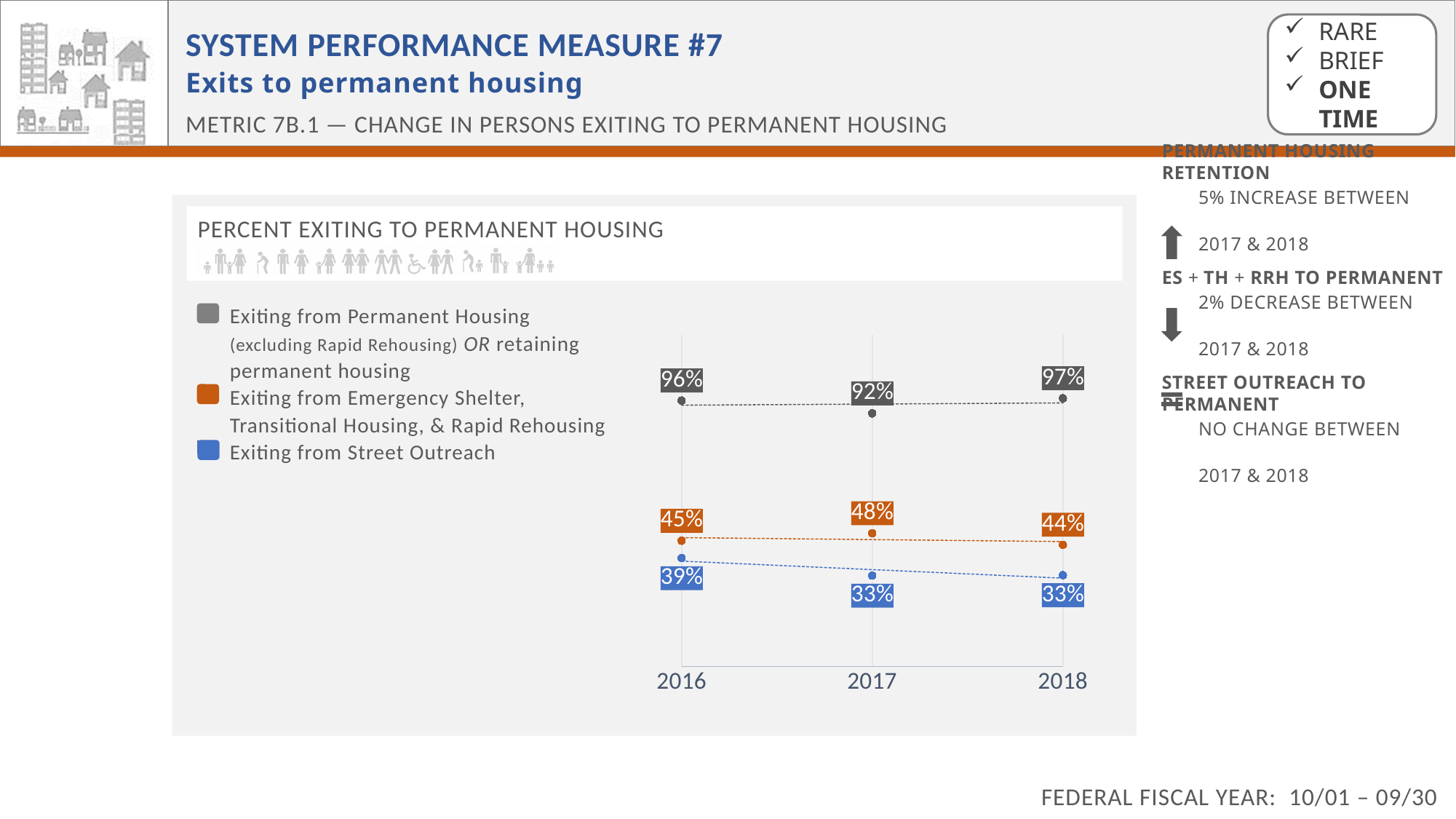
Does the Exiting from Street Outreach series rise or fall from 2016 to 2018? Fall Which is larger in 2018: the Exiting from Emergency Shelter, Transitional Housing, & Rapid Rehousing value or the Exiting from Street Outreach value? Exiting from Emergency Shelter, Transitional Housing, & Rapid Rehousing How many years are shown on the x axis? 3 What is the value for Exiting from Emergency Shelter, Transitional Housing, & Rapid Rehousing in 2017? 48% What is the value for Exiting from Street Outreach in 2018? 33% How many series does the legend list? 3 What kind of chart is shown? Line chart What is the value for Exiting from Permanent Housing in 2016? 96% What is the difference between the Exiting from Permanent Housing value and the Exiting from Street Outreach value in 2016? 57% In which year is the Exiting from Permanent Housing series highest? 2018 In which year is the Exiting from Permanent Housing series lowest? 2017 What is the title of the chart? PERCENT EXITING TO PERMANENT HOUSING